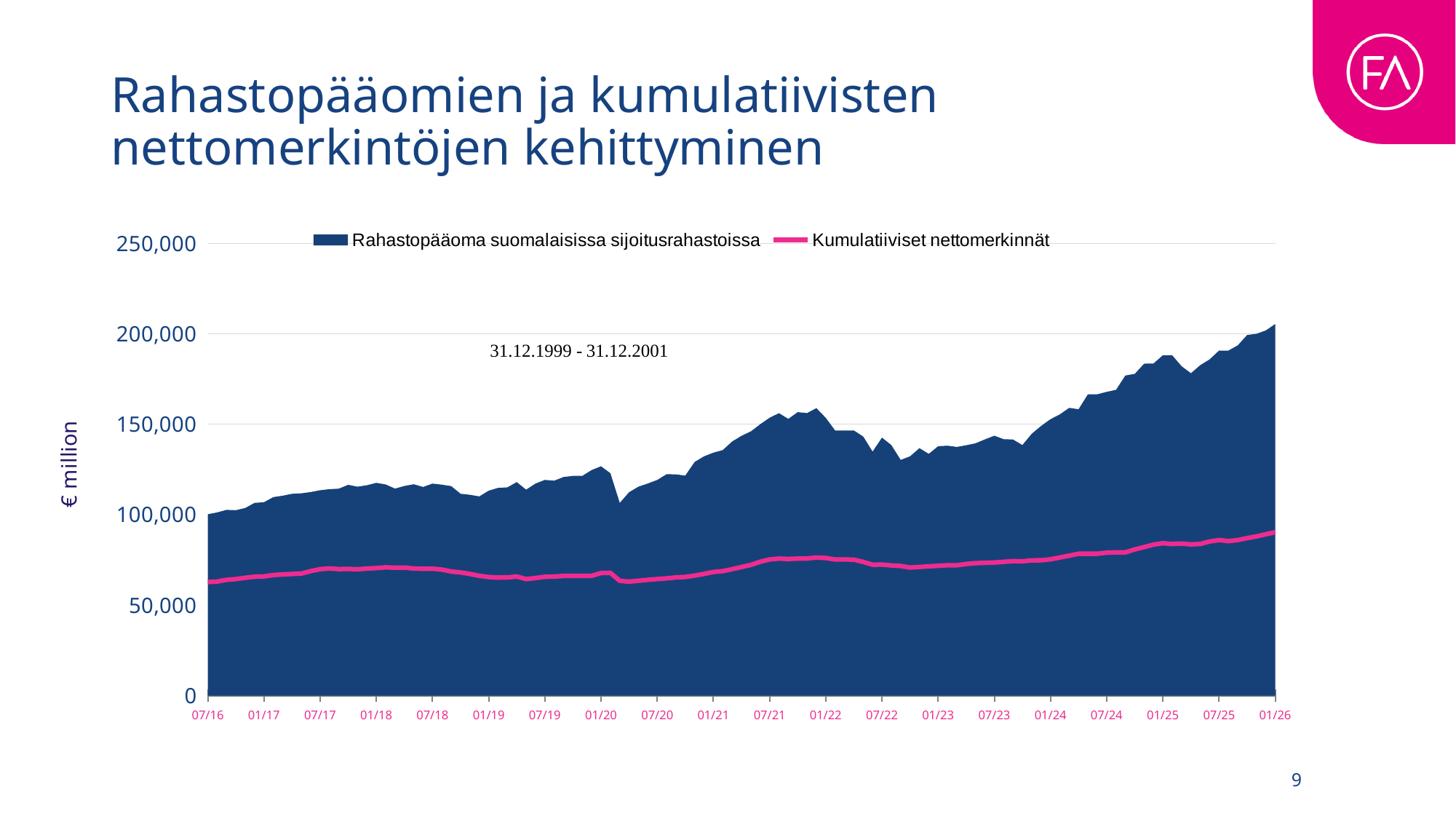
Is the value of Rahastopääoma suomalaisissa sijoitusrahastoissa at 07/16 greater or less than 150,000? less Is the value of Rahastopääoma suomalaisissa sijoitusrahastoissa at 01/26 greater or less than 150,000? greater Which series has the higher value at 01/26, Rahastopääoma suomalaisissa sijoitusrahastoissa or Kumulatiiviset nettomerkinnät? Rahastopääoma suomalaisissa sijoitusrahastoissa Overall, do the values of Kumulatiiviset nettomerkinnät rise or fall from 07/16 to 01/26? rise At which x-axis date does Rahastopääoma suomalaisissa sijoitusrahastoissa reach its highest value? 01/26 What kind of chart is shown on the slide? Area chart with a line series What are the two series named in the chart legend? Rahastopääoma suomalaisissa sijoitusrahastoissa; Kumulatiiviset nettomerkinnät Is the value of Kumulatiiviset nettomerkinnät at 01/26 greater or less than 100,000? less How many series does the chart legend list? 2 What is the label on the vertical axis of the chart? € million At which x-axis date is Rahastopääoma suomalaisissa sijoitusrahastoissa at its lowest value? 07/16